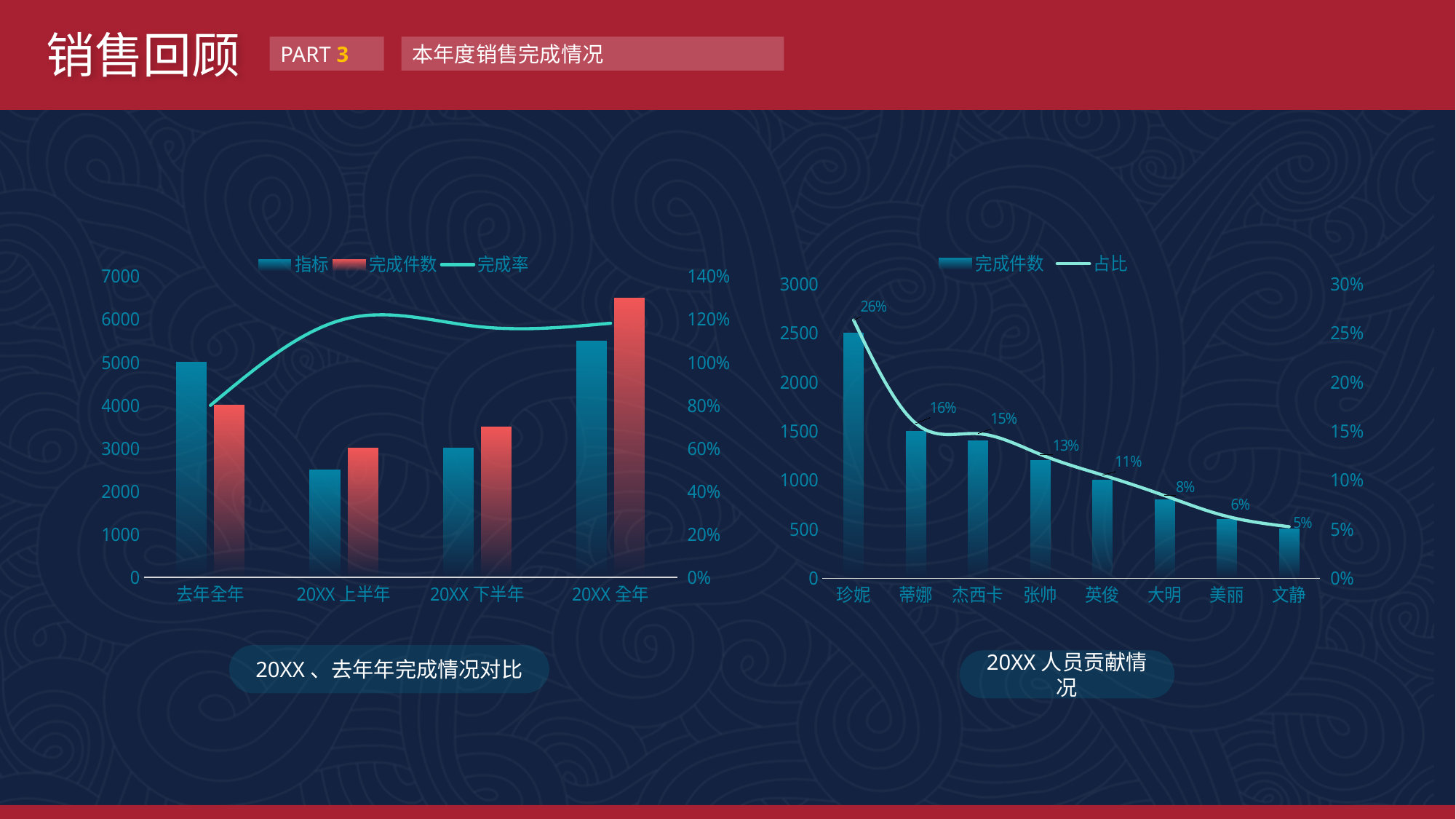
In the chart titled '20XX 人员贡献情况', what is the 占比 value for 珍妮? 26% In the chart titled '20XX 、去年年完成情况对比', which is larger, the 完成件数 bar for 20XX 全年 or for 去年全年? 20XX 全年 In the chart titled '20XX 人员贡献情况', is the 完成件数 bar for 珍妮 greater or less than 2000? greater In the chart titled '20XX 、去年年完成情况对比', is the 完成件数 bar for 20XX 全年 greater or less than 6000? greater In the chart titled '20XX 人员贡献情况', which person has the lowest 占比? 文静 In the chart titled '20XX 人员贡献情况', does the 占比 line rise or fall from left to right? fall In the chart titled '20XX 人员贡献情况', which person has the highest 占比? 珍妮 In the chart titled '20XX 人员贡献情况', what is the difference between the 占比 of 珍妮 and 文静? 21% In the chart titled '20XX 人员贡献情况', what is the 占比 value for 张帅? 13% In the chart titled '20XX 人员贡献情况', how many people are shown on the x axis? 8 In the chart titled '20XX 、去年年完成情况对比', how many categories are on the x axis? 4 In the chart titled '20XX 、去年年完成情况对比', how many series does the legend list? 3